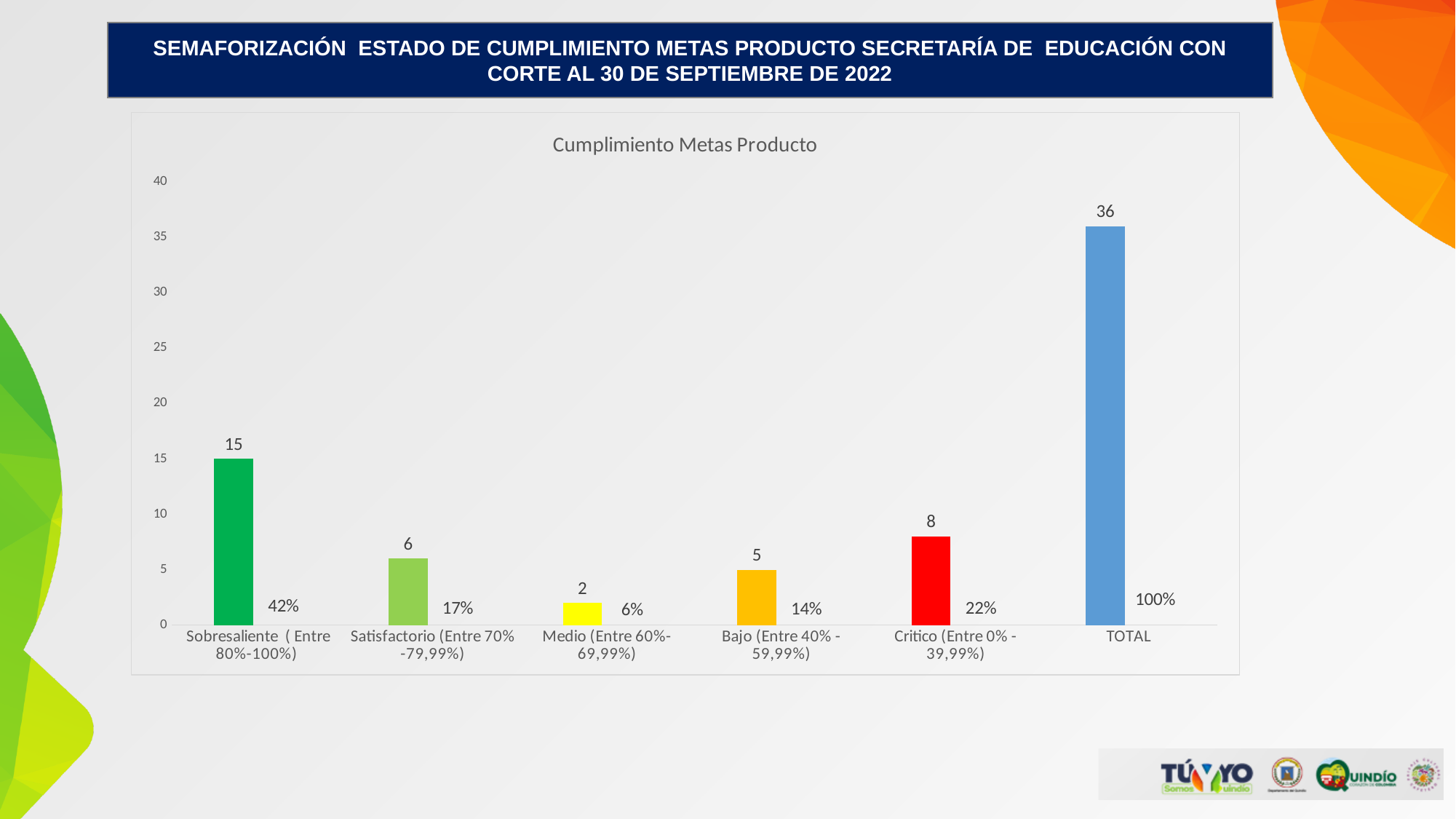
Which category has the lowest value? Medio (Entre 60%-69,99%) What is the value for TOTAL? 36 What kind of chart is shown? bar chart What is the value for Sobresaliente (Entre 80%-100%)? 15 What is the difference between the values for Sobresaliente and Critico? 7 What is the title of the chart? Cumplimiento Metas Producto Is the value for TOTAL greater or less than 35? greater Excluding TOTAL, which category has the highest value? Sobresaliente (Entre 80%-100%) Which is larger, the value for Bajo (Entre 40% - 59,99%) or Satisfactorio (Entre 70% -79,99%)? Satisfactorio (Entre 70% -79,99%) How many categories are shown on the x axis? 6 What is the value for Critico (Entre 0% - 39,99%)? 8 What percentage is shown next to the Satisfactorio (Entre 70% -79,99%) bar? 17%